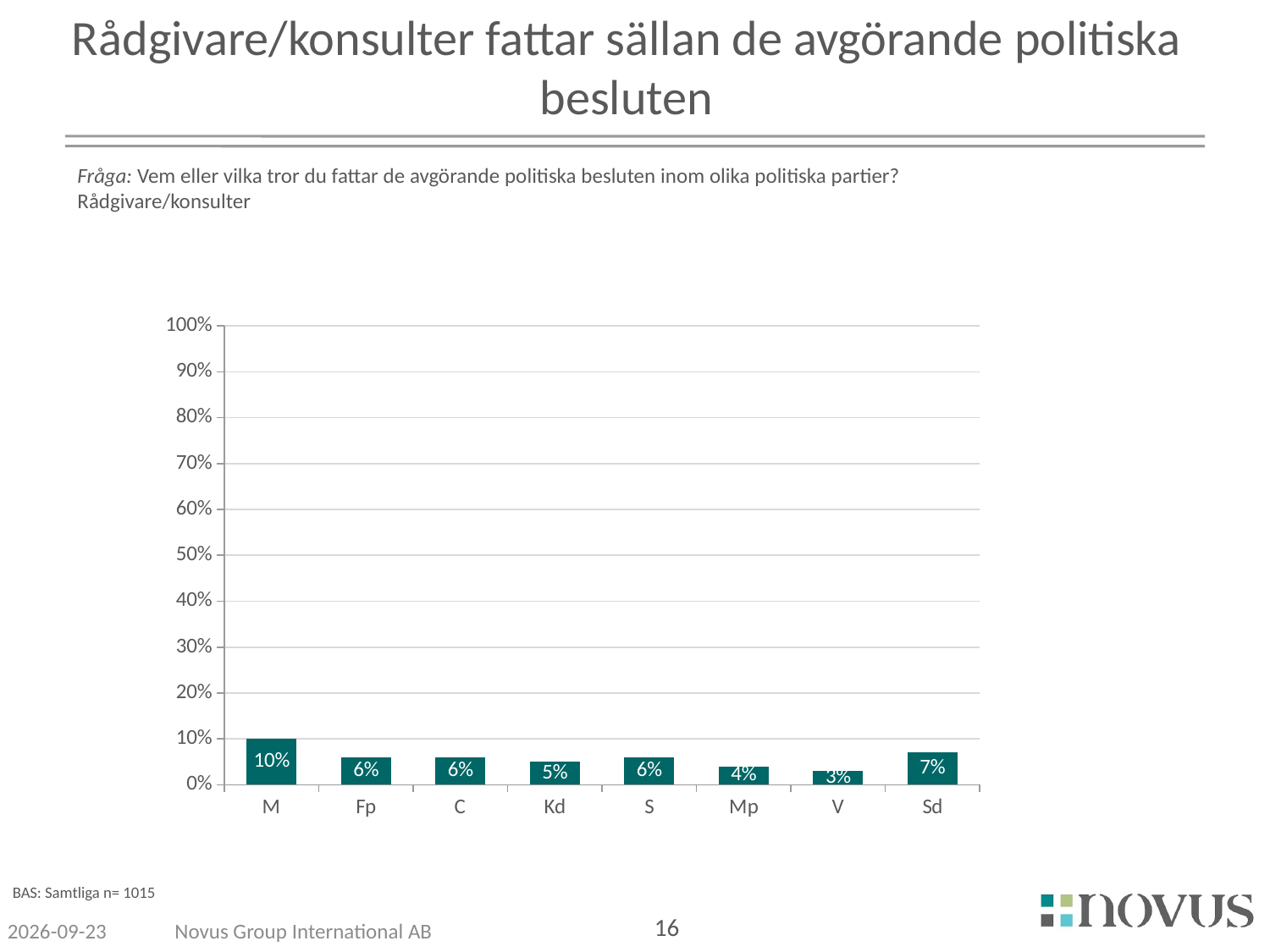
What is the value for Kd? 5% What kind of chart is shown on the slide? bar chart Is the value for M greater or less than 20%? less What is the highest value shown on the y axis? 100% What is the difference between the values for M and Sd? 3% What is the value for V? 3% What is the value for Sd? 7% Which party has the highest value? M Which party has the lowest value? V How many parties are shown on the x axis? 8 Which is larger, the value for Mp or the value for Sd? Sd What is the value for M? 10%